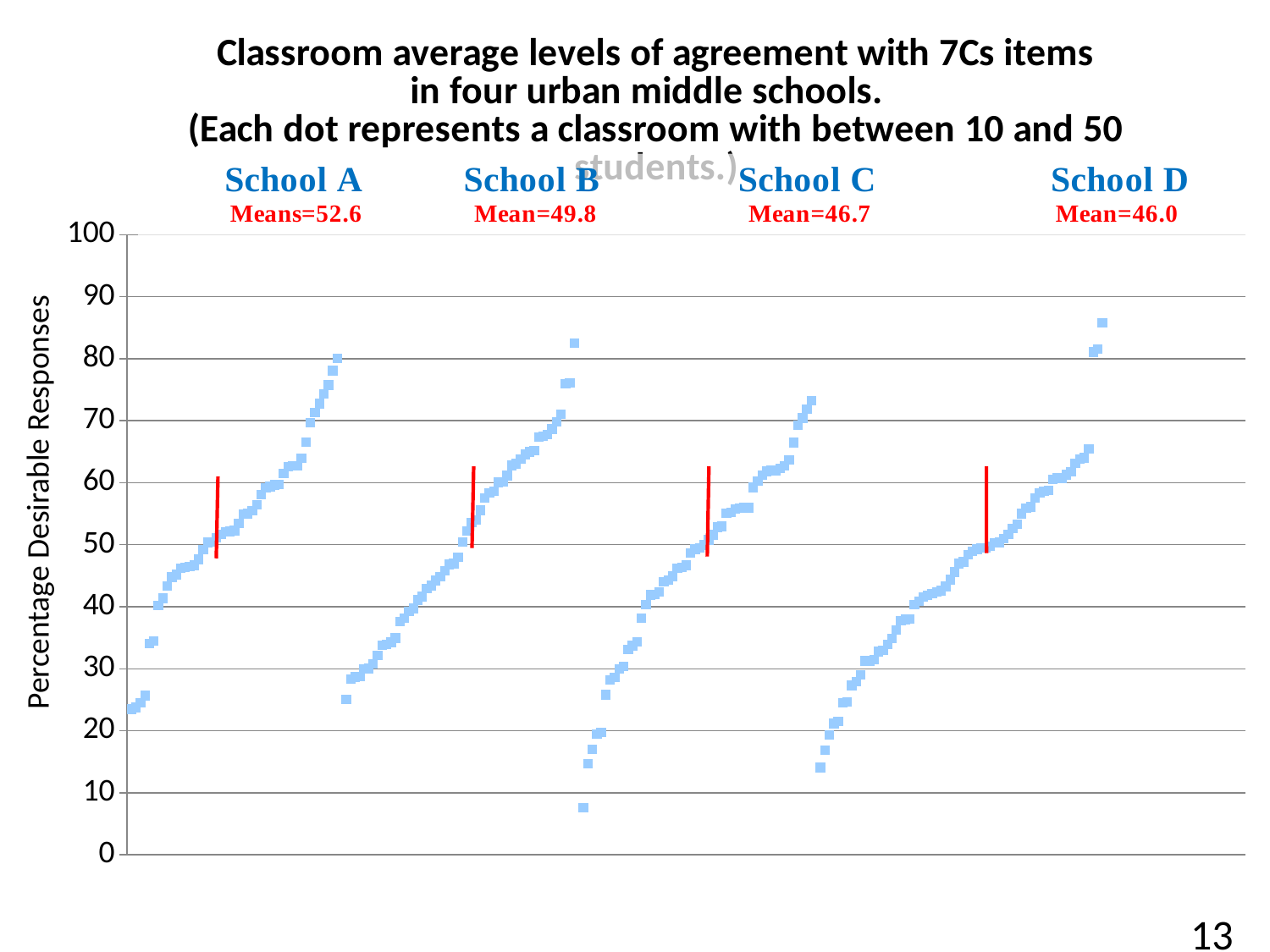
What is the label on the vertical axis? Percentage Desirable Responses What is the difference between the printed means of School A and School D? 6.6 Is the value of the lowest dot for School B greater or less than 10? greater Which school has the lowest printed mean? School D What is the mean printed for School C? 46.7 What is the mean printed for School A? 52.6 How many schools are shown on the chart? 4 What is the mean printed for School D? 46.0 What is the mean printed for School B? 49.8 Which has the larger printed mean, School B or School C? School B Which school has the highest printed mean? School A Is the value of the highest dot for School D greater or less than 80? greater